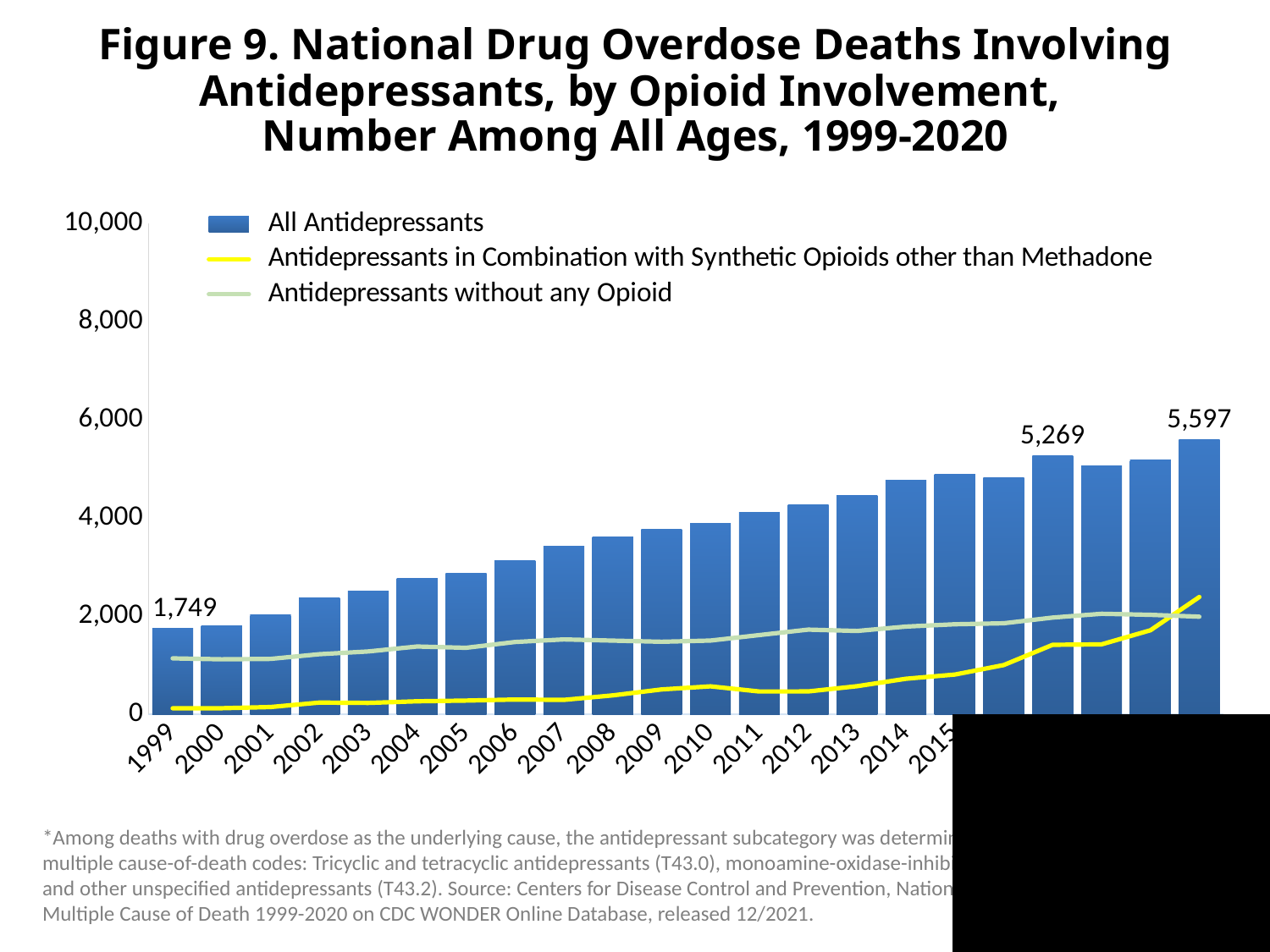
What kind of chart is shown on the slide? combination bar and line chart Which year has the lowest All Antidepressants bar? 1999 Which year has a larger All Antidepressants value, 2003 or 2013? 2013 Is the All Antidepressants value for 2008 greater or less than 4,000? less Do the All Antidepressants bars generally rise or fall from 1999 to 2020? rise What is the difference between the tallest bar (5,597) and the 1999 bar (1,749)? 3,848 What is the value of the All Antidepressants bar for 1999? 1,749 What is the value of the tallest All Antidepressants bar? 5,597 Is the All Antidepressants value for 2005 greater or less than 2,000? greater What colour is the line for Antidepressants in Combination with Synthetic Opioids other than Methadone? yellow How many series does the legend list? 3 Is the Antidepressants without any Opioid value for 2010 greater or less than 2,000? less